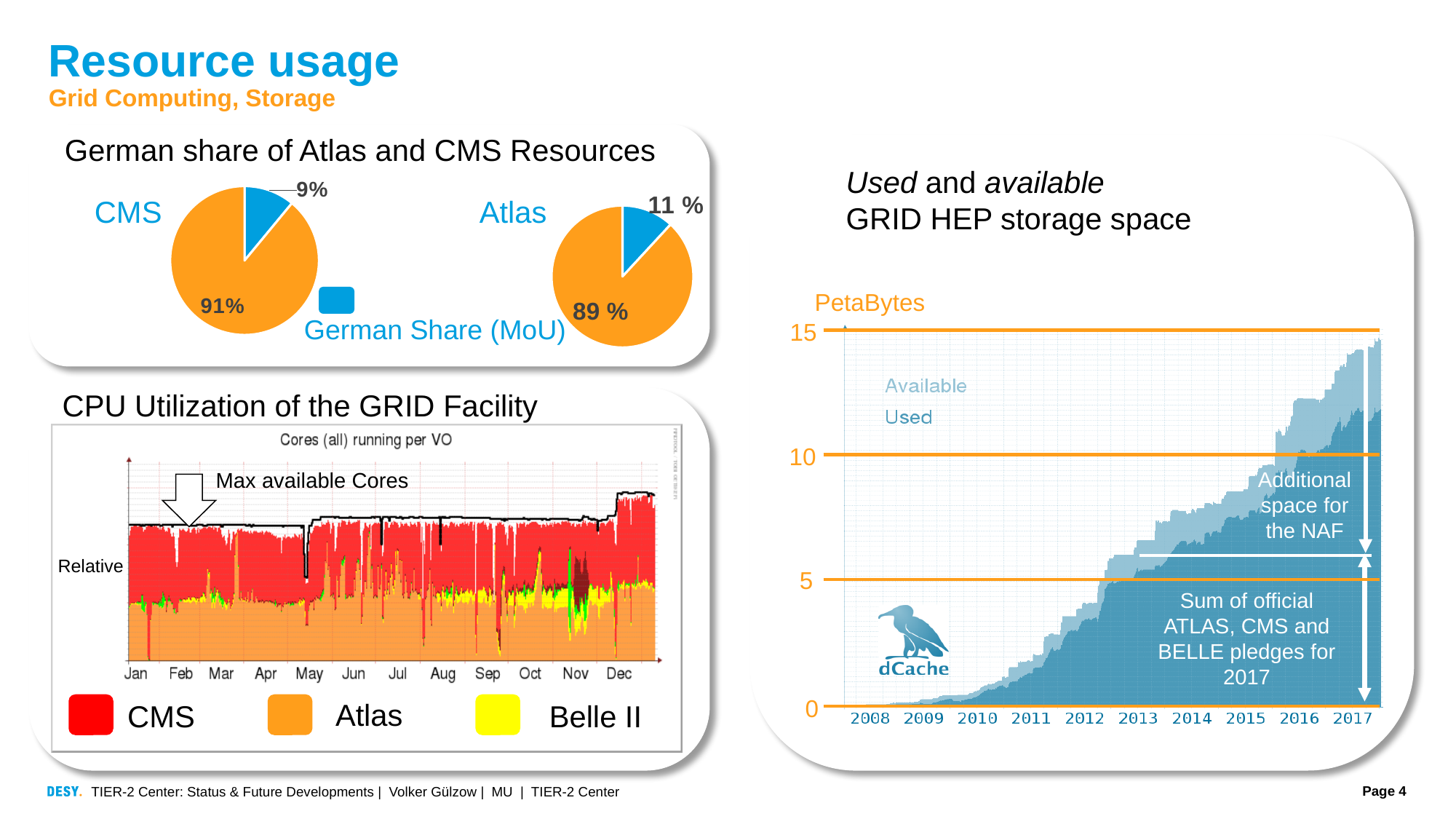
In the 'German share of Atlas and CMS Resources' pie charts, what is the German Share (MoU) for Atlas? 11 % In the 'German share of Atlas and CMS Resources' pie charts, by how many percentage points does the Atlas German share exceed the CMS German share? 2 percentage points In the 'CPU Utilization of the GRID Facility' chart, how many series does the legend list? 3 What kind of charts are used for 'German share of Atlas and CMS Resources'? Pie charts In the 'CPU Utilization of the GRID Facility' chart, which colour represents CMS? Red In the 'Used and available GRID HEP storage space' chart, what unit is shown on the y axis? PetaBytes In the 'CPU Utilization of the GRID Facility' chart, how many months are labelled on the x axis? 12 In the 'Used and available GRID HEP storage space' chart, is the Used storage in 2017 greater or less than 10 PetaBytes? greater In the 'Used and available GRID HEP storage space' chart, does the storage space rise or fall from 2008 to 2017? Rise In the 'German share of Atlas and CMS Resources' pie charts, which experiment has the larger German Share (MoU), CMS or Atlas? Atlas In the CMS pie chart, what share is not the German Share (MoU)? 91% In the 'German share of Atlas and CMS Resources' pie charts, what is the German Share (MoU) for CMS? 9%